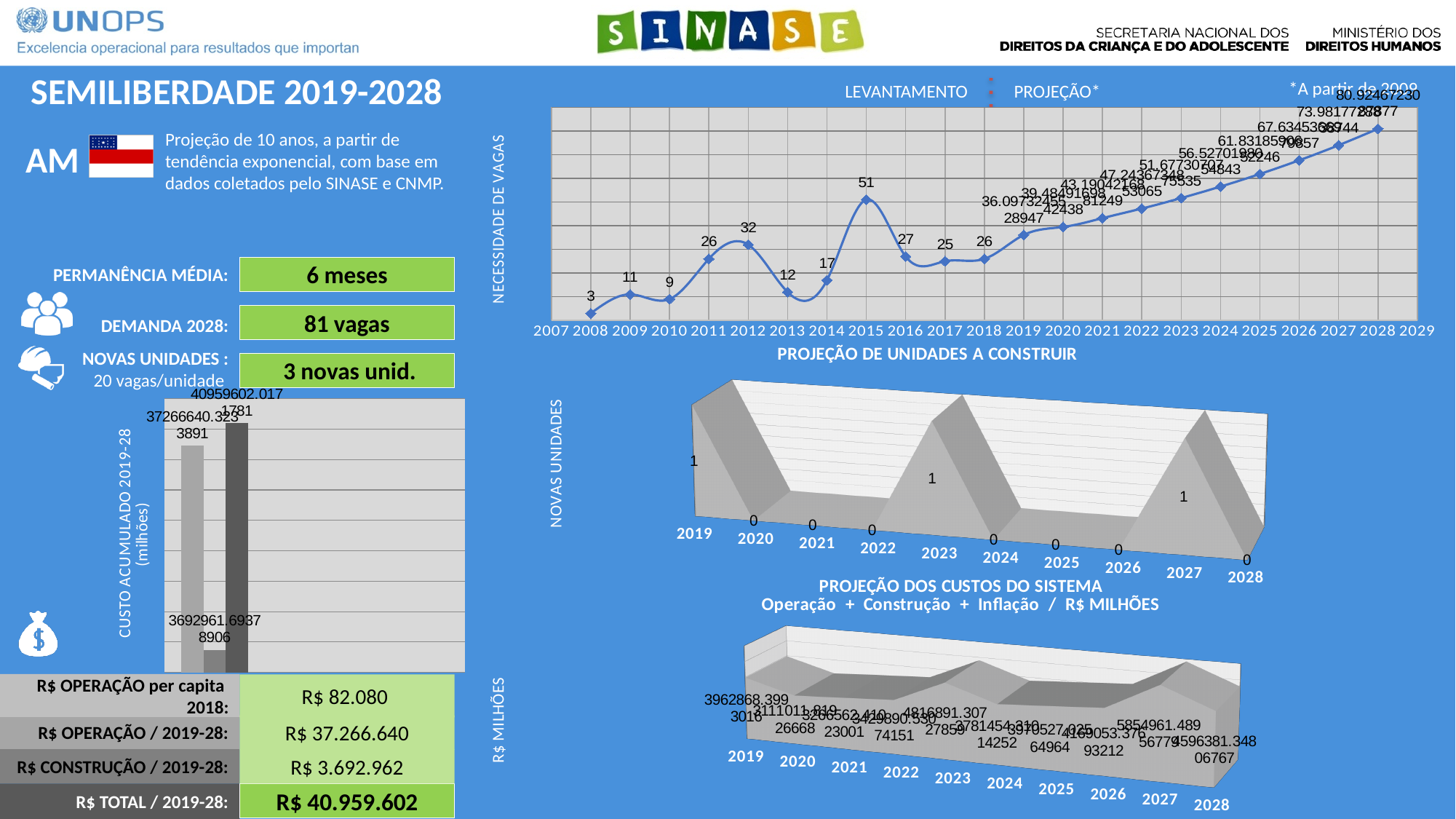
In the PROJEÇÃO DE UNIDADES A CONSTRUIR chart, what is the value for 2023? 1 In the NECESSIDADE DE VAGAS line chart, which year has the lowest value? 2008 In the NECESSIDADE DE VAGAS line chart, what is the difference between the values for 2015 and 2016? 24 In the NECESSIDADE DE VAGAS line chart, what is the value for 2012? 32 What kind of chart is the NECESSIDADE DE VAGAS chart? line chart How many series does the legend of the NECESSIDADE DE VAGAS chart list? 2 In the NECESSIDADE DE VAGAS line chart, what is the value for 2015? 51 In the NECESSIDADE DE VAGAS chart, do the values rise or fall from 2018 to 2028? rise In the NECESSIDADE DE VAGAS line chart, what is the value for 2008? 3 How many years are shown on the x axis of the PROJEÇÃO DE UNIDADES A CONSTRUIR chart? 10 In the NECESSIDADE DE VAGAS line chart, which year has the larger value, 2011 or 2013? 2011 In the PROJEÇÃO DE UNIDADES A CONSTRUIR chart, how many years show a value of 1? 3